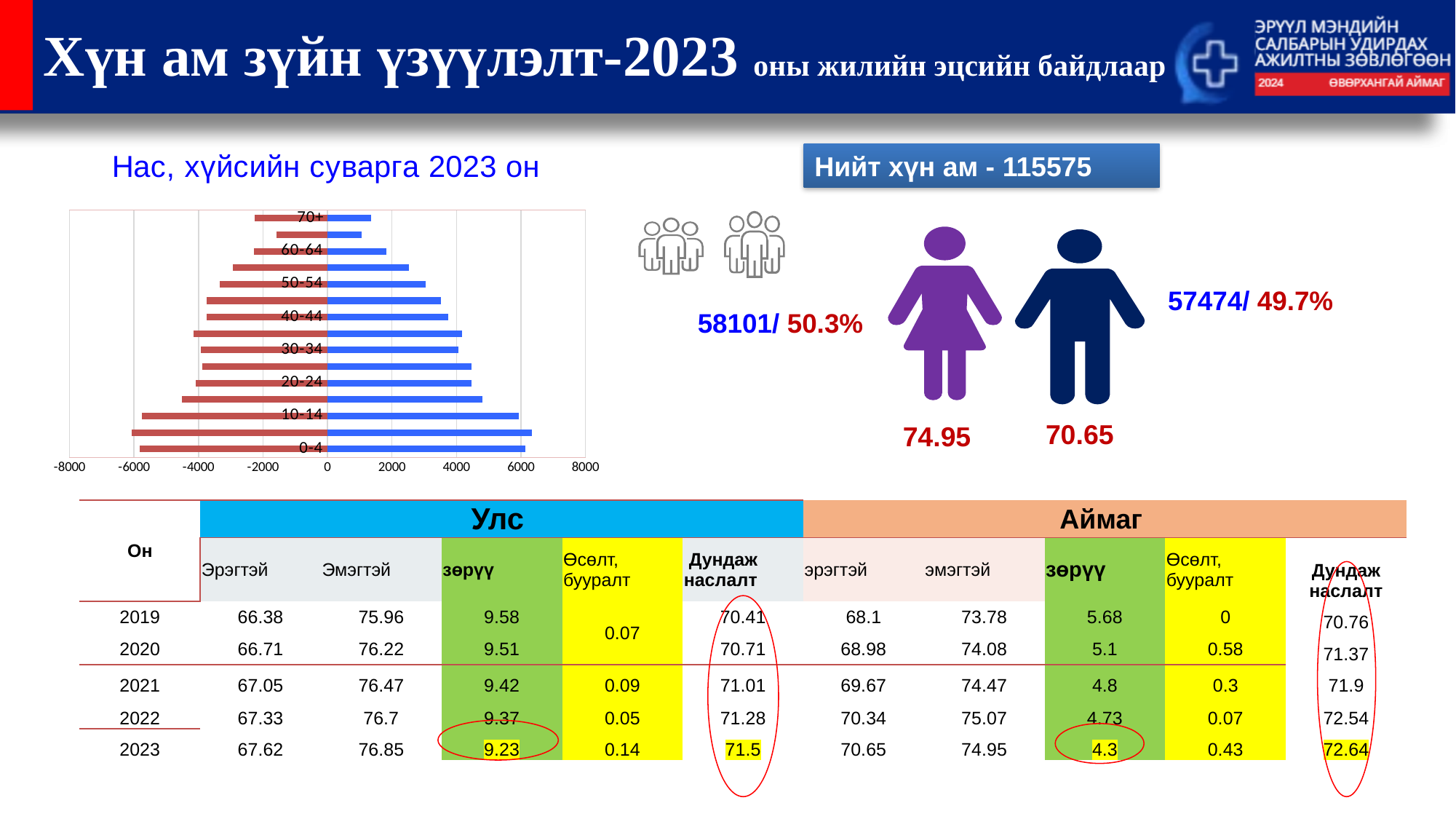
In the population pyramid chart, is the blue bar for the 40-44 age group greater or less than 4000? less In the population pyramid chart, is the blue bar for the 70+ age group greater or less than 2000? less How many age-group rows (bars per side) does the population pyramid chart contain? 15 In the population pyramid chart, which blue bar is longer: 0-4 or 70+? 0-4 What kind of chart is shown under the heading "Нас, хүйсийн суварга 2023 он"? bar chart In the population pyramid chart, is the blue bar for the 50-54 age group greater or less than 2000? greater In the population pyramid chart, do the bars generally get longer or shorter as the age group increases from 0-4 to 70+? shorter What are the minimum and maximum values shown on the horizontal axis of the population pyramid chart? -8000 and 8000 In the population pyramid chart, which blue bar is longer: 40-44 or 50-54? 40-44 What is the title of the chart on the left of the slide? Нас, хүйсийн суварга 2023 он